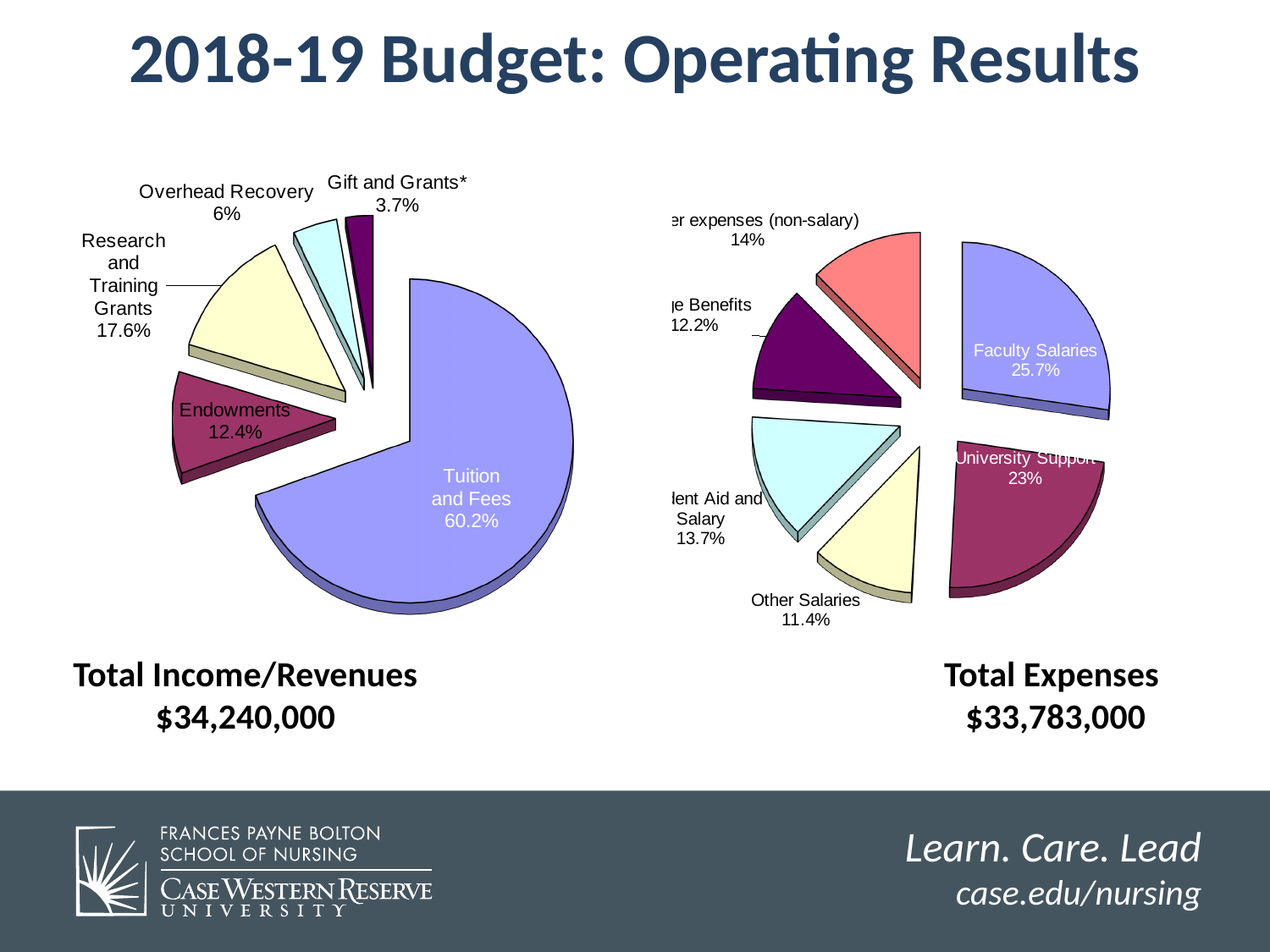
On the Total Expenses pie chart, which is larger, Faculty Salaries or University Support? Faculty Salaries On the Total Income/Revenues pie chart, what percentage is shown for Research and Training Grants? 17.6% On the Total Income/Revenues pie chart, what is the difference in percentage points between Research and Training Grants and Overhead Recovery? 11.6 On the Total Expenses pie chart, what share does Faculty Salaries account for? 25.7% On the Total Expenses pie chart, what percentage is shown for University Support? 23% On the Total Income/Revenues pie chart, which category has the smallest share? Gift and Grants* On the Total Income/Revenues pie chart, how many slices are there? 5 On the Total Income/Revenues pie chart, what percentage is shown for Endowments? 12.4% What type of chart is used for the Total Expenses data on the right of the slide? Pie chart On the Total Income/Revenues pie chart, what share does Tuition and Fees account for? 60.2% On the Total Expenses pie chart, what percentage is shown for Other Salaries? 11.4% On the Total Income/Revenues pie chart, which category has the largest share? Tuition and Fees